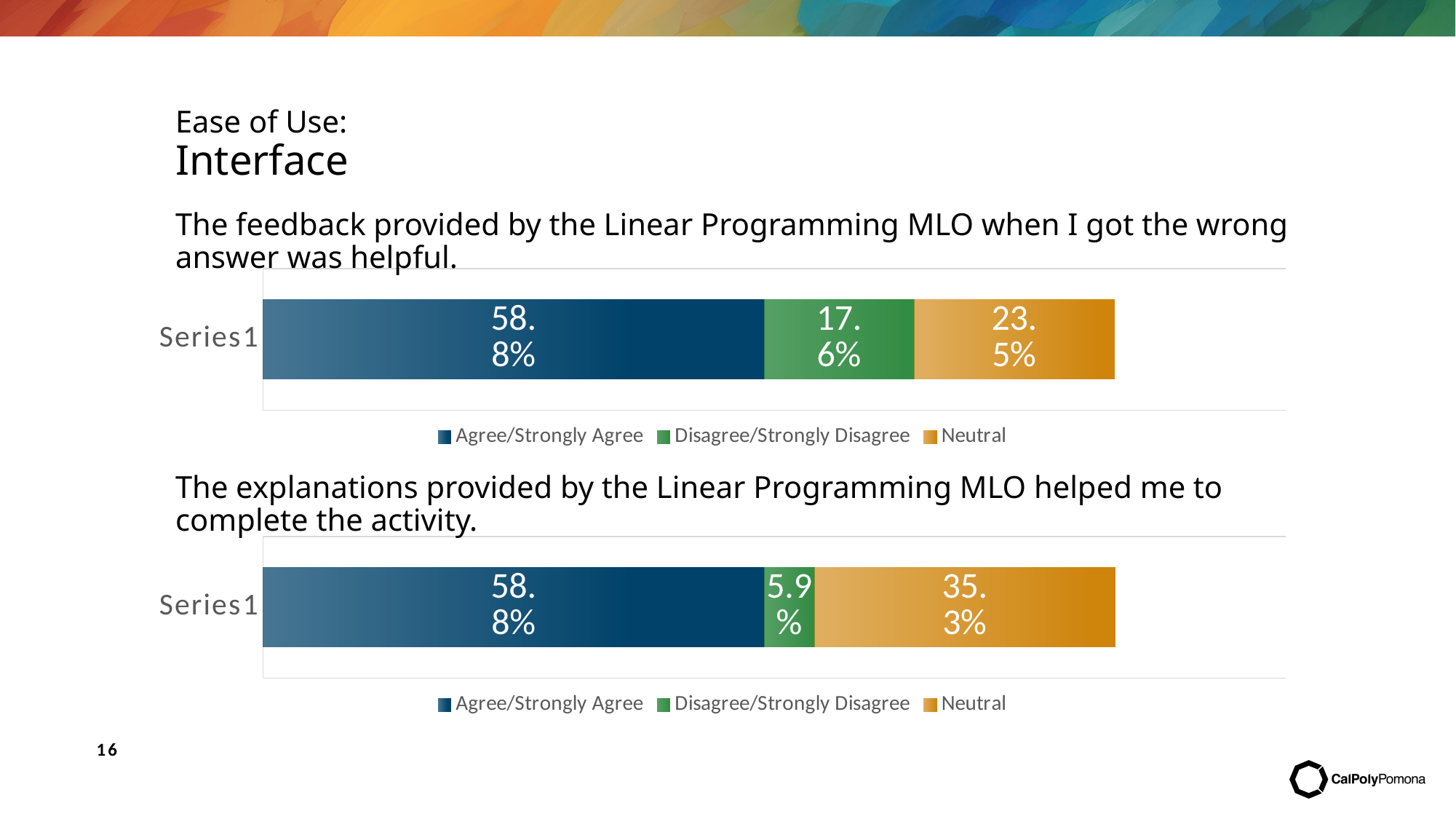
In the bottom chart (explanations helped me complete the activity), what percentage is shown for Disagree/Strongly Disagree? 5.9% What is the total of the three segments in the bottom chart (explanations helped me complete the activity)? 100% In the top chart (feedback was helpful), what percentage is shown for Agree/Strongly Agree? 58.8% In the bottom chart (explanations helped me complete the activity), what percentage is shown for Neutral? 35.3% What type of chart is used for the bottom chart (explanations helped me complete the activity)? Stacked bar chart In the top chart (feedback was helpful), what is the difference between the Neutral and Disagree/Strongly Disagree percentages? 5.9% In the top chart (feedback was helpful), what percentage is shown for Disagree/Strongly Disagree? 17.6% In the bottom chart (explanations helped me complete the activity), which is larger: Neutral or Disagree/Strongly Disagree? Neutral In the bottom chart (explanations helped me complete the activity), which response category has the largest share? Agree/Strongly Agree In the top chart (feedback was helpful), what percentage is shown for Neutral? 23.5% In the top chart (feedback was helpful), which response category has the smallest share? Disagree/Strongly Disagree How many series does the legend of the top chart list? 3